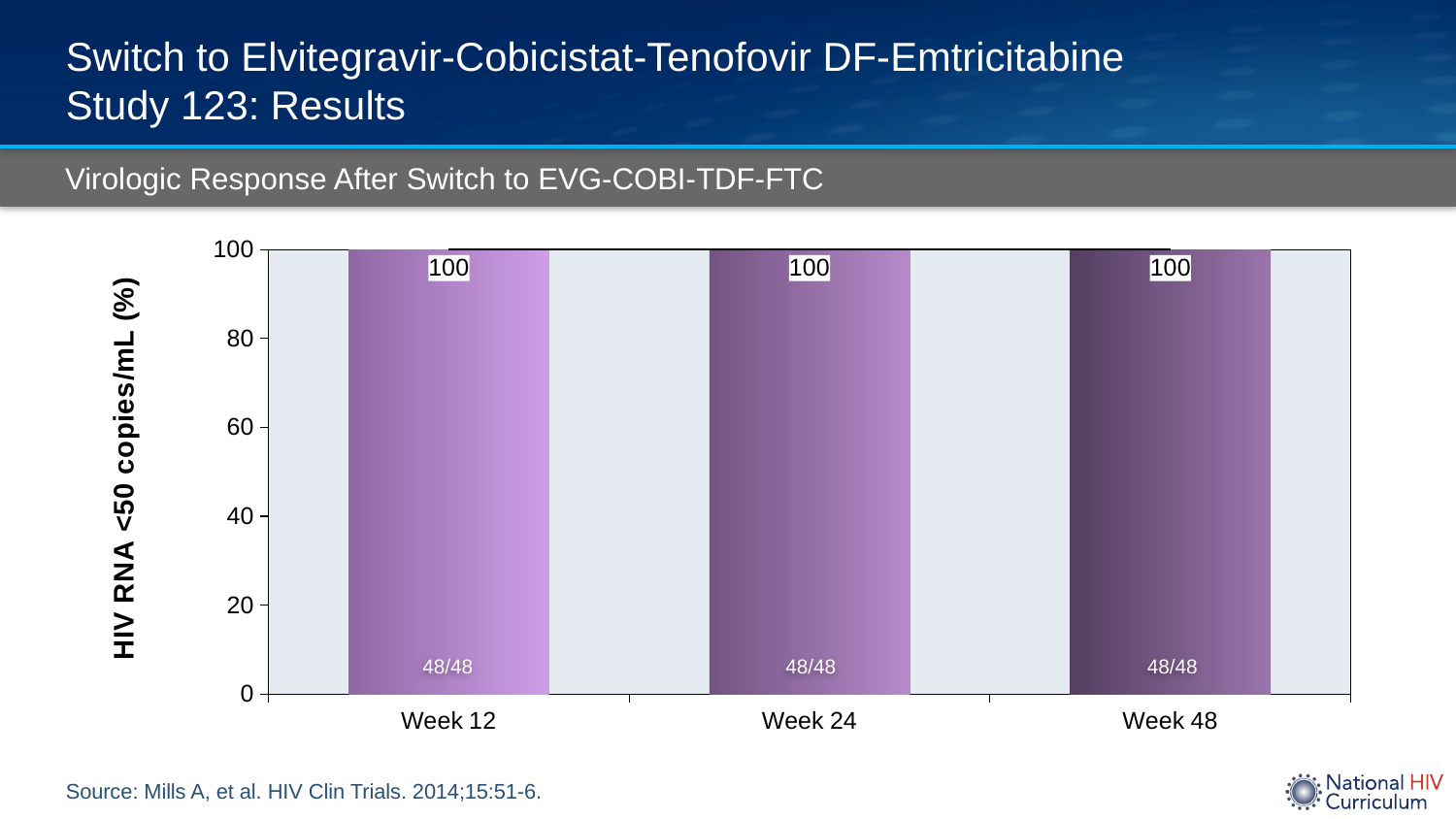
Do the values rise, fall, or stay the same from Week 12 to Week 48? Stay the same What is the value for Week 48? 100 Is the value for Week 24 greater or less than 80? greater What is the title of the chart? Virologic Response After Switch to EVG-COBI-TDF-FTC What kind of chart is shown on the slide? Bar chart What is the value for Week 12? 100 How many categories are shown on the x axis? 3 What is the label of the y axis? HIV RNA <50 copies/mL (%) What is the difference between the values for Week 12 and Week 48? 0 What is the value for Week 24? 100 What fraction of participants is shown inside the Week 48 bar? 48/48